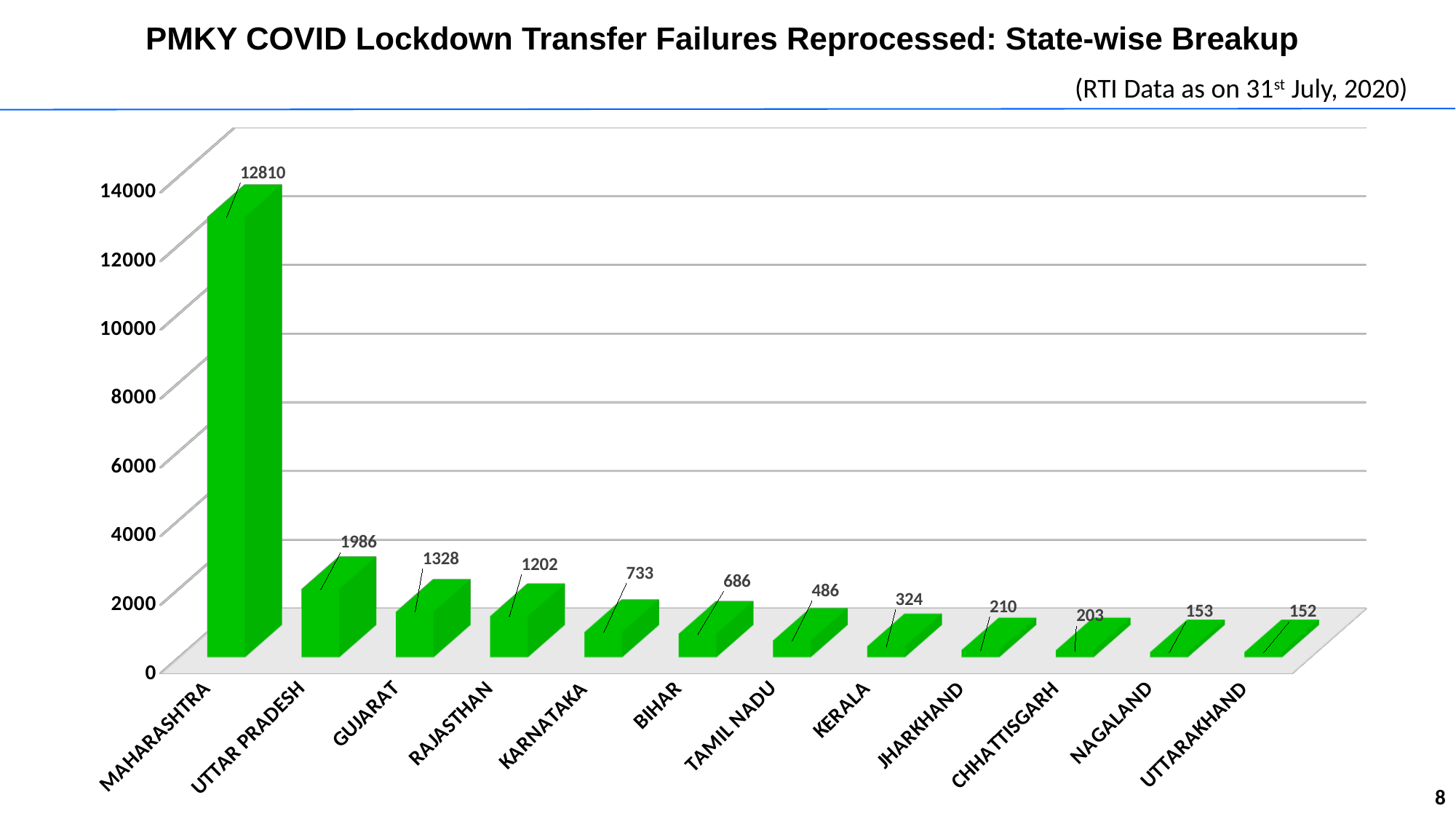
Do the values rise or fall from left to right along the x axis? fall What is the value for Gujarat? 1328 What is the value for Tamil Nadu? 486 Which state has the highest value? Maharashtra What is the difference between the values for Uttar Pradesh and Gujarat? 658 Which state has the lowest value? Uttarakhand Is the value for Uttar Pradesh greater or less than 2000? less What is the title of the chart? PMKY COVID Lockdown Transfer Failures Reprocessed: State-wise Breakup What is the value for Maharashtra? 12810 Which is larger, the value for Karnataka or the value for Bihar? Karnataka How many states are shown on the chart? 12 What kind of chart is shown on the slide? bar chart